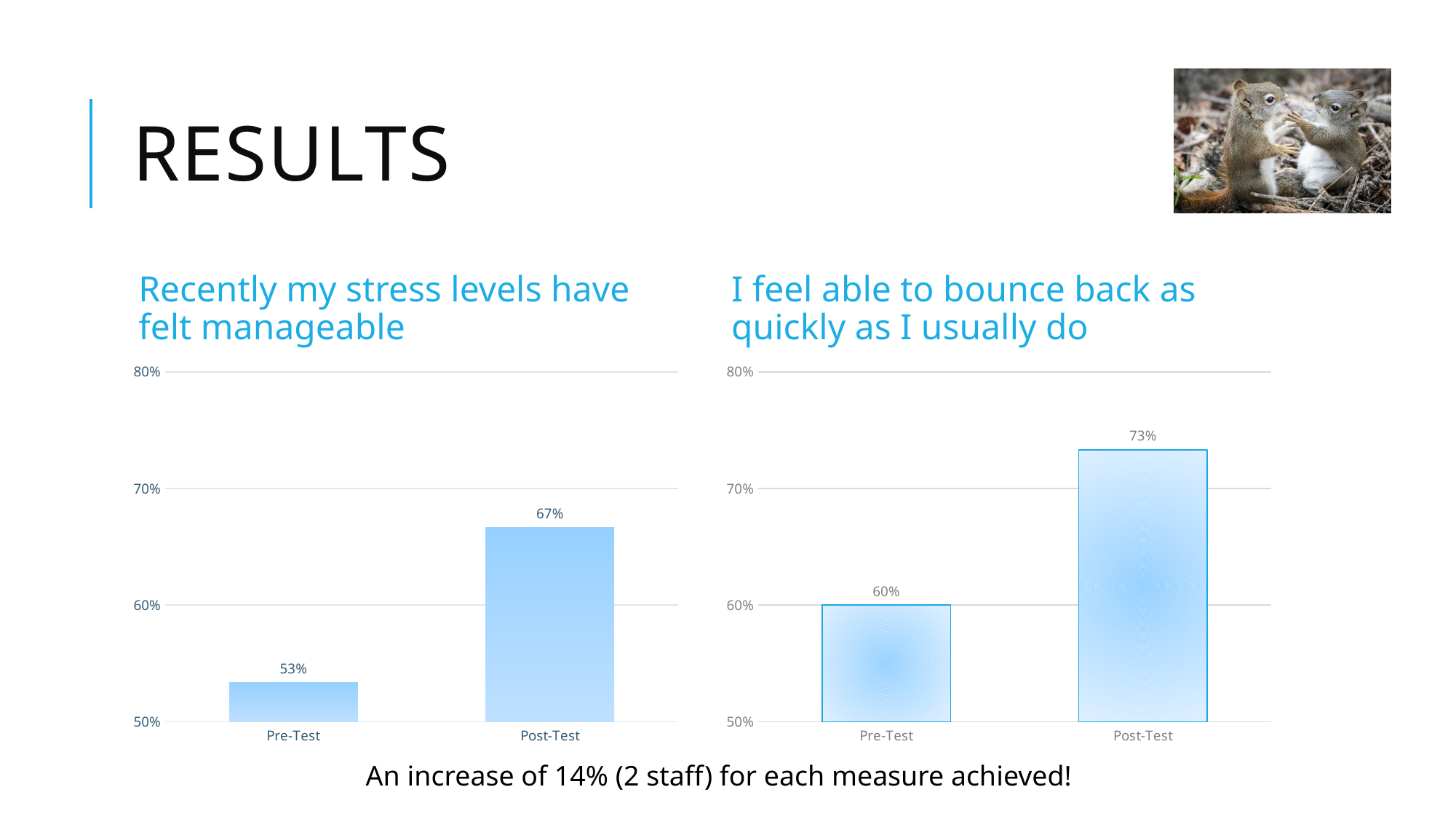
In the chart titled "Recently my stress levels have felt manageable", what is the difference between the Post-Test and Pre-Test values? 14% In the chart titled "Recently my stress levels have felt manageable", what is the value for Pre-Test? 53% In the chart titled "Recently my stress levels have felt manageable", which category has the highest value? Post-Test In the chart titled "I feel able to bounce back as quickly as I usually do", is the Post-Test value greater or less than 70%? greater In the chart titled "Recently my stress levels have felt manageable", do the values rise or fall from Pre-Test to Post-Test? rise In the chart titled "Recently my stress levels have felt manageable", what is the value for Post-Test? 67% In the chart titled "I feel able to bounce back as quickly as I usually do", which category has the lowest value? Pre-Test What kind of chart is the chart on the left of the slide? bar chart In the chart titled "I feel able to bounce back as quickly as I usually do", what is the value for Post-Test? 73% In the chart titled "I feel able to bounce back as quickly as I usually do", what is the value for Pre-Test? 60% In the chart titled "Recently my stress levels have felt manageable", how many categories are shown on the x axis? 2 In the chart titled "I feel able to bounce back as quickly as I usually do", what is the difference between the Post-Test and Pre-Test values? 13%